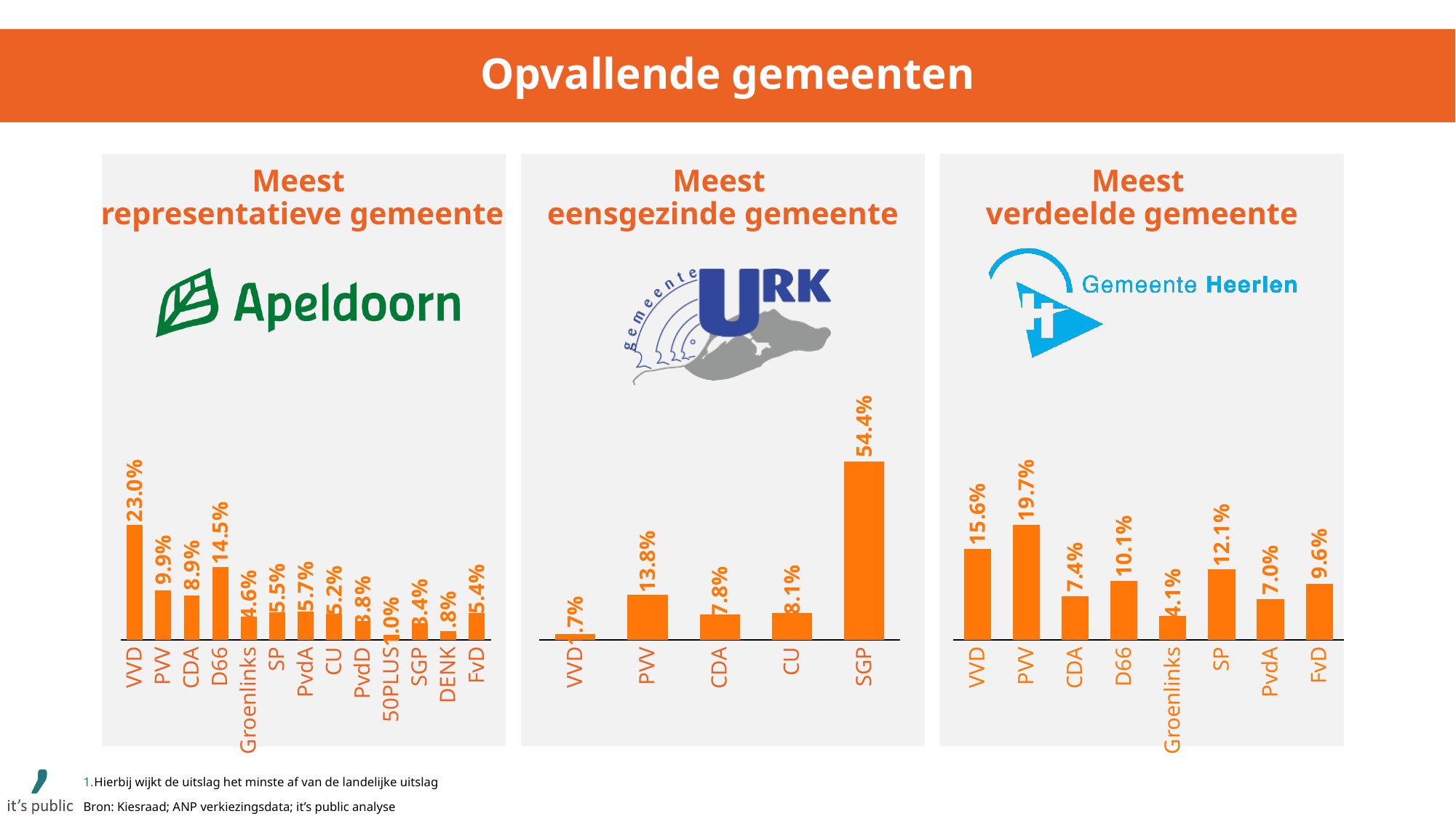
In the 'Meest eensgezinde gemeente' chart (Urk), what is the difference between the values for SGP and PVV? 40.6% In the 'Meest verdeelde gemeente' chart (Heerlen), what is the difference between the values for PVV and VVD? 4.1% In the 'Meest representatieve gemeente' chart (Apeldoorn), which party has the highest value? VVD In the 'Meest verdeelde gemeente' chart (Heerlen), what is the value for SP? 12.1% In the 'Meest verdeelde gemeente' chart (Heerlen), which party has the highest value? PVV In the 'Meest representatieve gemeente' chart (Apeldoorn), what is the value for D66? 14.5% How many parties are shown in the 'Meest eensgezinde gemeente' chart (Urk)? 5 In the 'Meest eensgezinde gemeente' chart (Urk), what is the value for SGP? 54.4% What kind of chart is used in the 'Meest verdeelde gemeente' panel (Heerlen)? Bar chart In the 'Meest representatieve gemeente' chart (Apeldoorn), which is larger, the value for PVV or the value for CDA? PVV How many parties are shown in the 'Meest verdeelde gemeente' chart (Heerlen)? 8 In the 'Meest eensgezinde gemeente' chart (Urk), which party has the lowest value? VVD